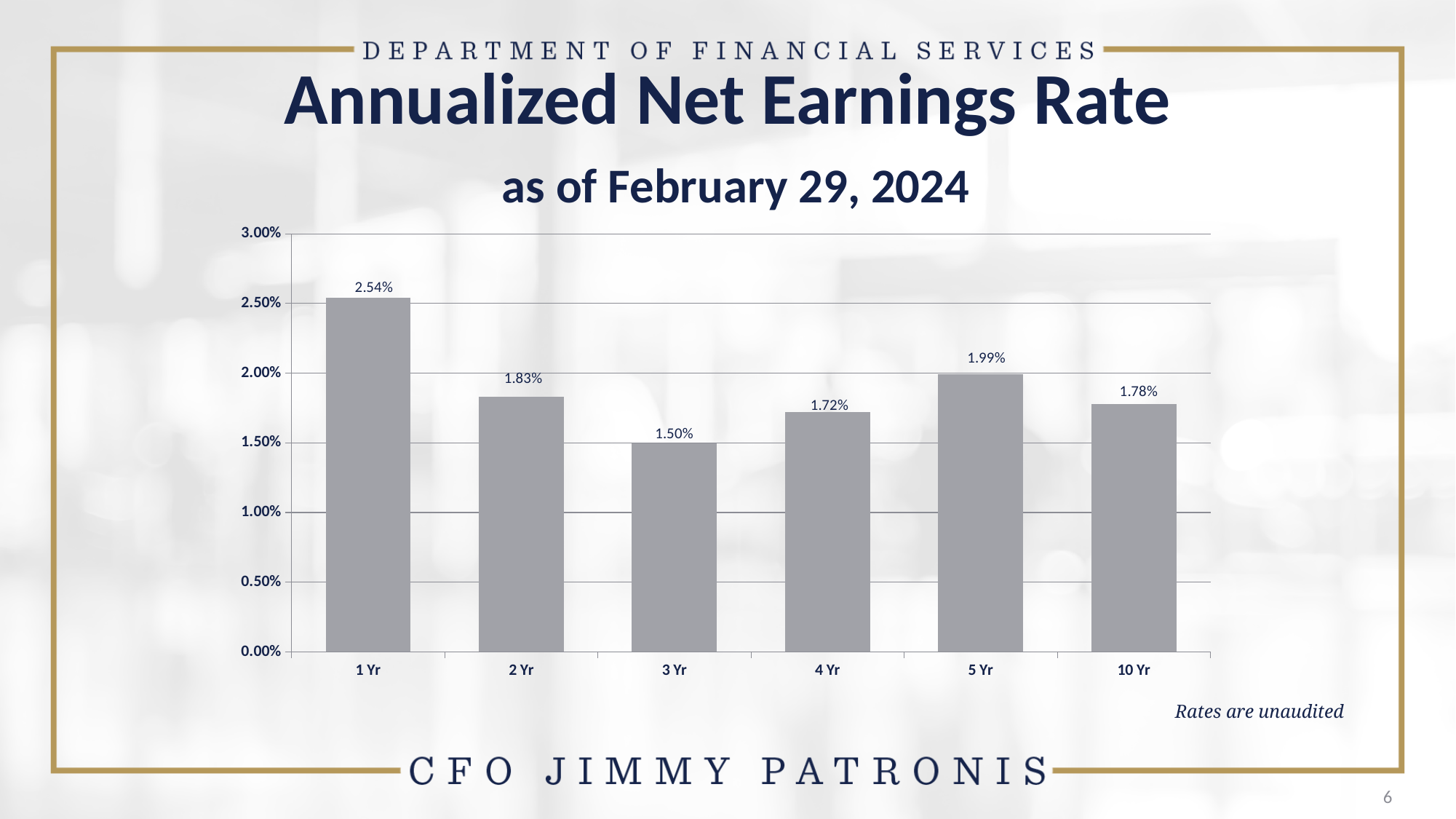
What kind of chart is shown on the slide? Bar chart Which period has the lowest annualized net earnings rate? 3 Yr What is the annualized net earnings rate for 10 Yr? 1.78% What is the difference between the 5 Yr and 4 Yr annualized net earnings rates? 0.27% What is the annualized net earnings rate for 3 Yr? 1.50% Which is larger, the 5 Yr rate or the 10 Yr rate? 5 Yr Is the value for 4 Yr greater or less than 2.00%? less What is the annualized net earnings rate for 1 Yr? 2.54% How many periods are shown on the chart? 6 Which period has the highest annualized net earnings rate? 1 Yr As of what date are the annualized net earnings rates reported? February 29, 2024 What is the difference between the 1 Yr and 2 Yr annualized net earnings rates? 0.71%